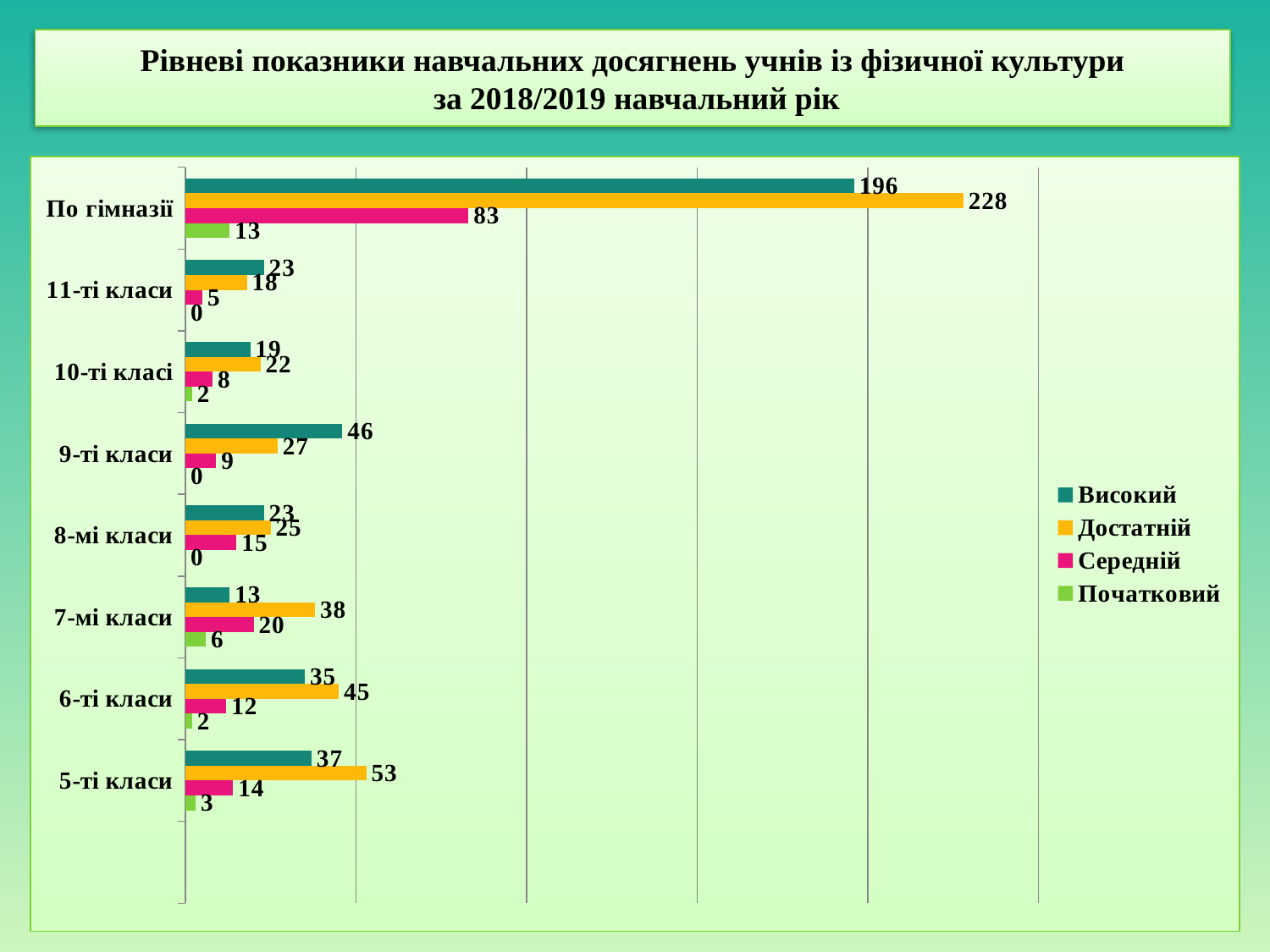
How many categories are shown on the chart? 8 Among the class categories (excluding По гімназії), which has the lowest Високий value? 7-мі класи What is the value of Середній for 7-мі класи? 20 What is the value of Високий for 9-ті класи? 46 Which is larger for 6-ті класи: Високий or Достатній? Достатній What kind of chart is shown on the slide? Bar chart Which series is shown in green in the legend? Початковий What is the value of Достатній for По гімназії? 228 How many series does the legend list? 4 Among the class categories (excluding По гімназії), which has the highest Достатній value? 5-ті класи What is the difference between the Достатній and Високий values for По гімназії? 32 What is the value of Початковий for 5-ті класи? 3